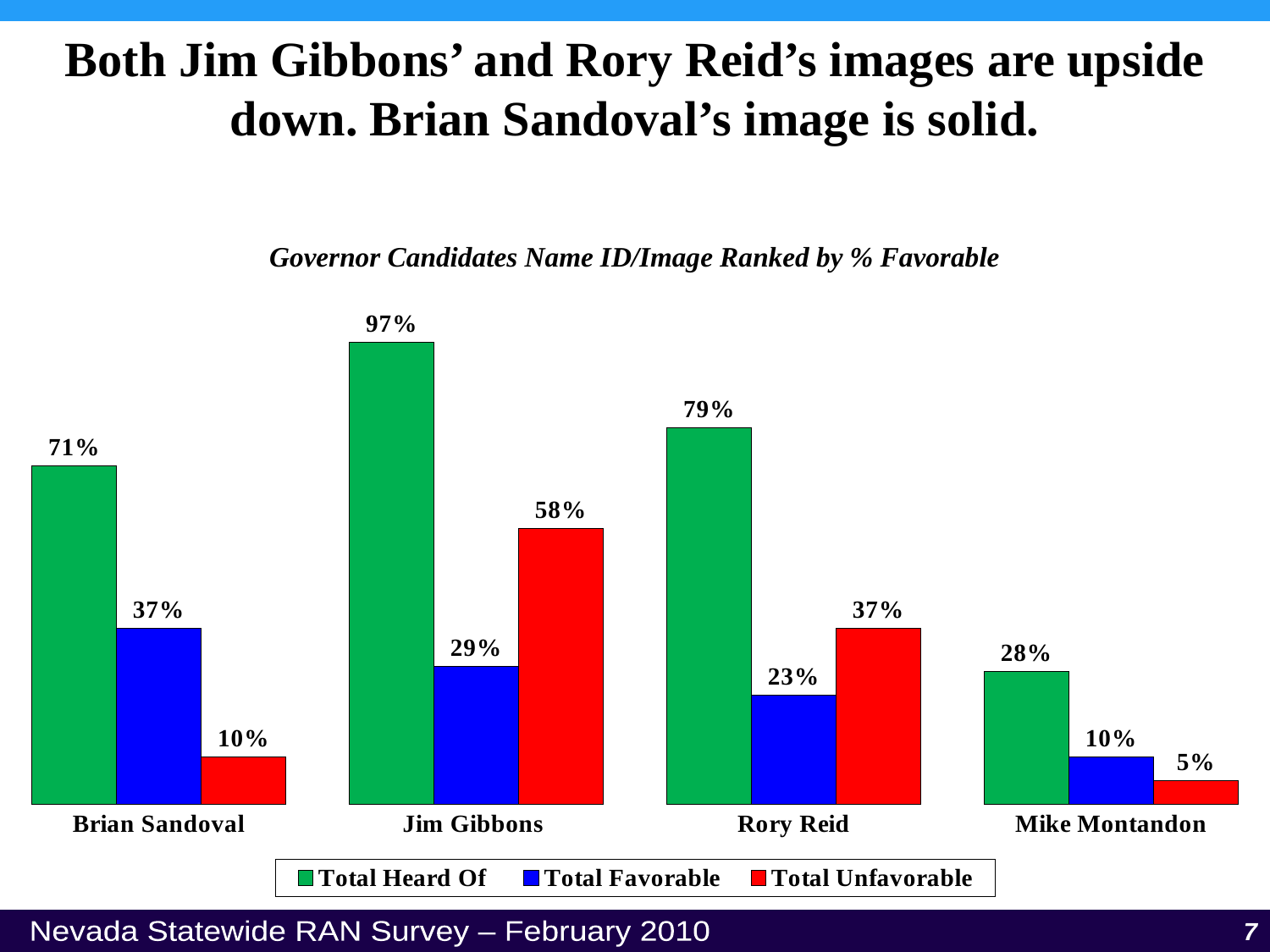
What is the difference between Jim Gibbons' Total Unfavorable and Total Favorable values? 29% What kind of chart is shown on the slide? Bar chart Which is larger for Rory Reid: Total Favorable or Total Unfavorable? Total Unfavorable What is the title of the chart? Governor Candidates Name ID/Image Ranked by % Favorable What is the Total Favorable value for Mike Montandon? 10% What is the Total Unfavorable value for Rory Reid? 37% How many series does the legend list? 3 Which candidate has the lowest Total Unfavorable value? Mike Montandon How many candidates are shown on the chart? 4 What is the Total Favorable value for Brian Sandoval? 37% What is the Total Heard Of value for Jim Gibbons? 97% Which candidate has the highest Total Heard Of value? Jim Gibbons